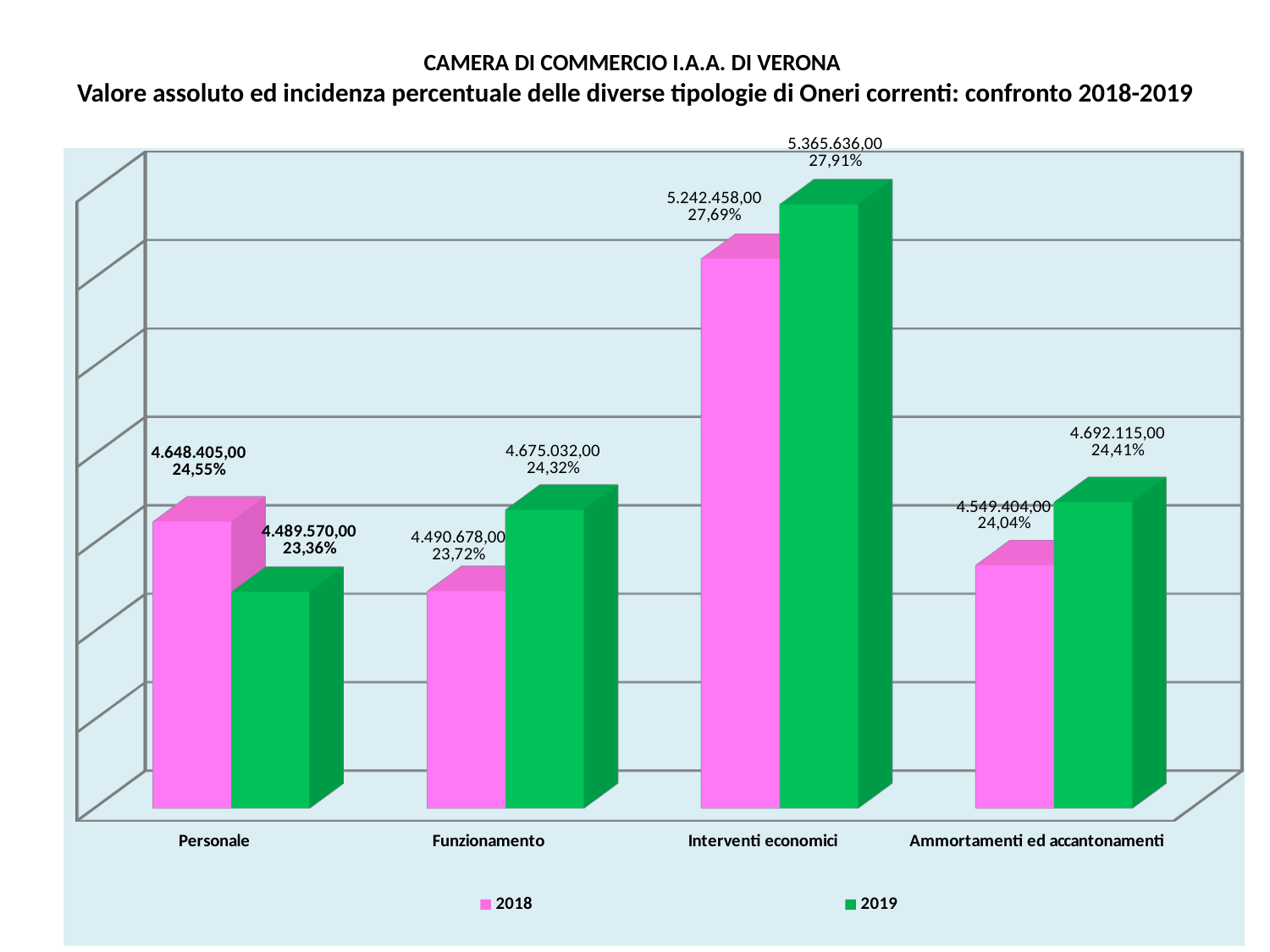
How many series does the legend list? 2 Which category has the lowest value in 2019? Personale What kind of chart is shown on the slide? Bar chart What is the difference between the 2018 and 2019 values for Personale? 158.835,00 What is the difference between the 2019 and 2018 values for Interventi economici? 123.178,00 What is the 2019 value for Interventi economici? 5.365.636,00 What percentage share is shown for Funzionamento in 2019? 24,32% How many categories are shown on the x axis? 4 What is the 2018 value for Personale? 4.648.405,00 Which category has the highest value in 2019? Interventi economici What is the 2018 value for Ammortamenti ed accantonamenti? 4.549.404,00 For Funzionamento, which year has the larger value, 2018 or 2019? 2019